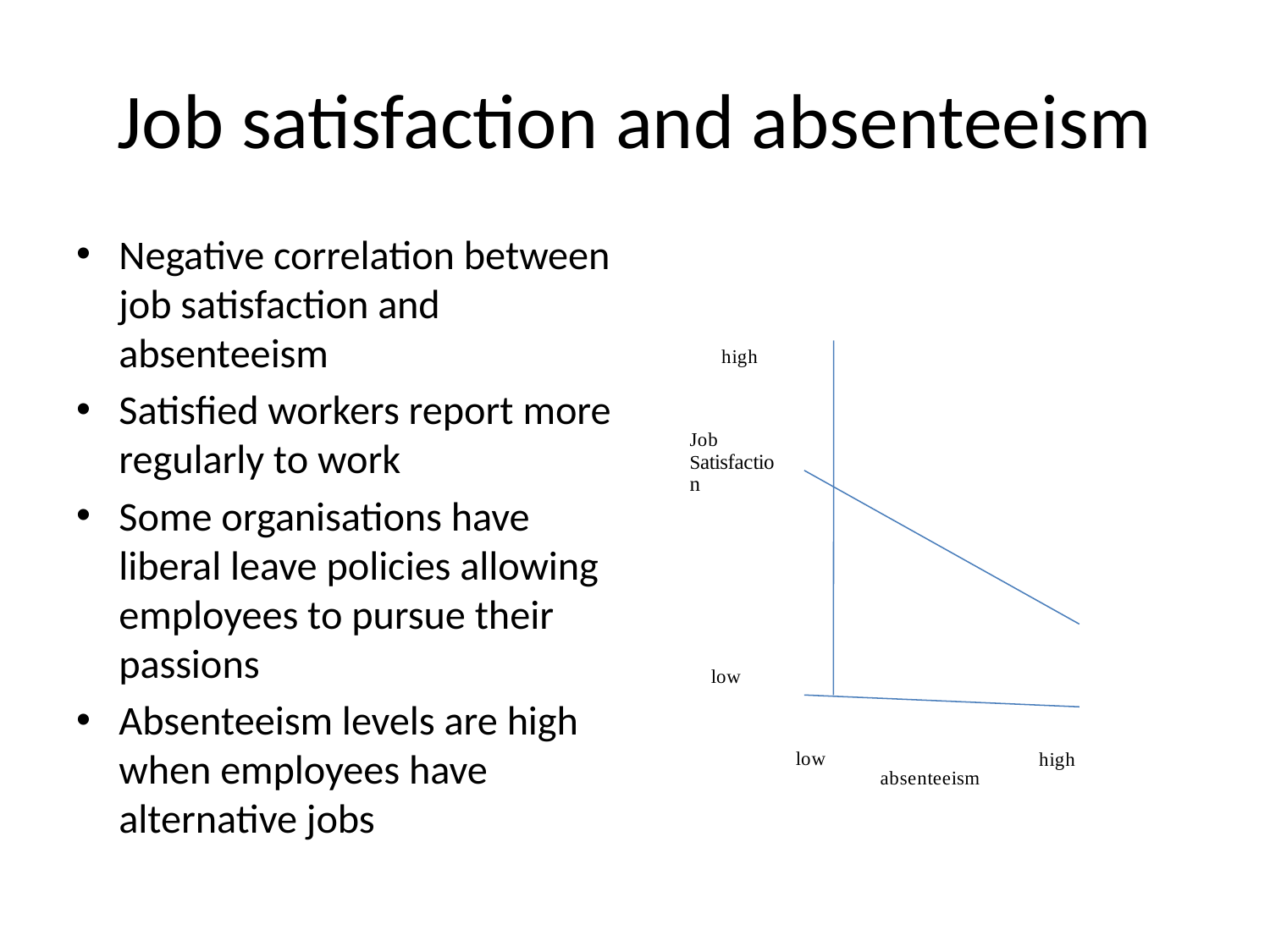
What kind of chart is shown on the right of the slide? line chart How many plotted lines does the diagram on the right show? 1 In the diagram on the right, does job satisfaction rise or fall as absenteeism increases along the x axis? fall What is the label of the horizontal axis of the diagram on the right? absenteeism What is the label of the vertical axis of the diagram on the right? Job Satisfaction